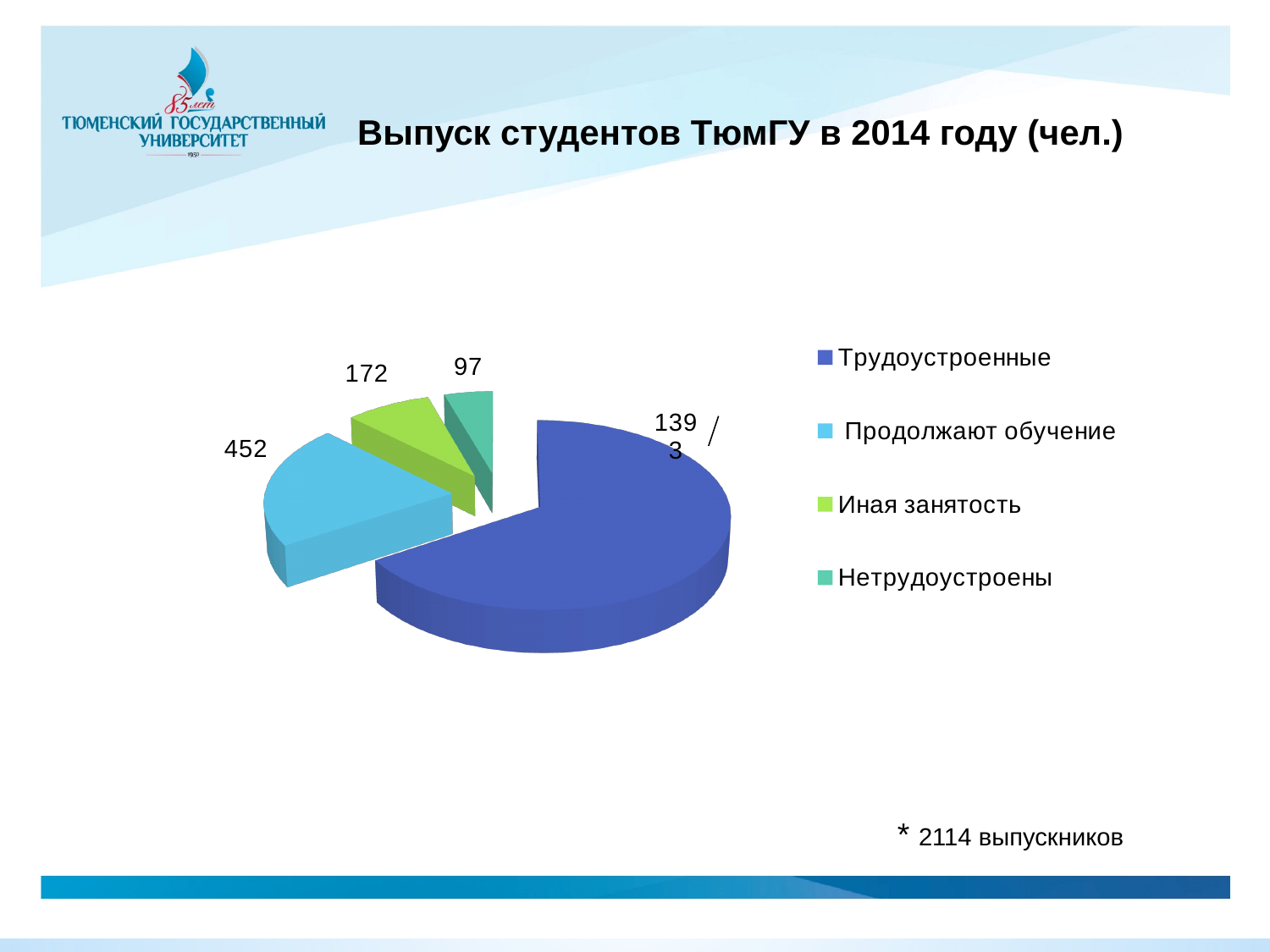
What is the difference between the values for Иная занятость and Нетрудоустроены? 75 What is the value for Иная занятость? 172 Which category has the largest slice of the pie? Трудоустроенные What colour is the slice for Иная занятость? green How many categories does the pie chart have? 4 What is the difference between the values for Продолжают обучение and Иная занятость? 280 Which is larger, Продолжают обучение or Иная занятость? Продолжают обучение Which category has the smallest slice of the pie? Нетрудоустроены What is the title of the chart? Выпуск студентов ТюмГУ в 2014 году (чел.) What is the value for Продолжают обучение? 452 What kind of chart is shown on the slide? pie chart What is the value for Нетрудоустроены? 97